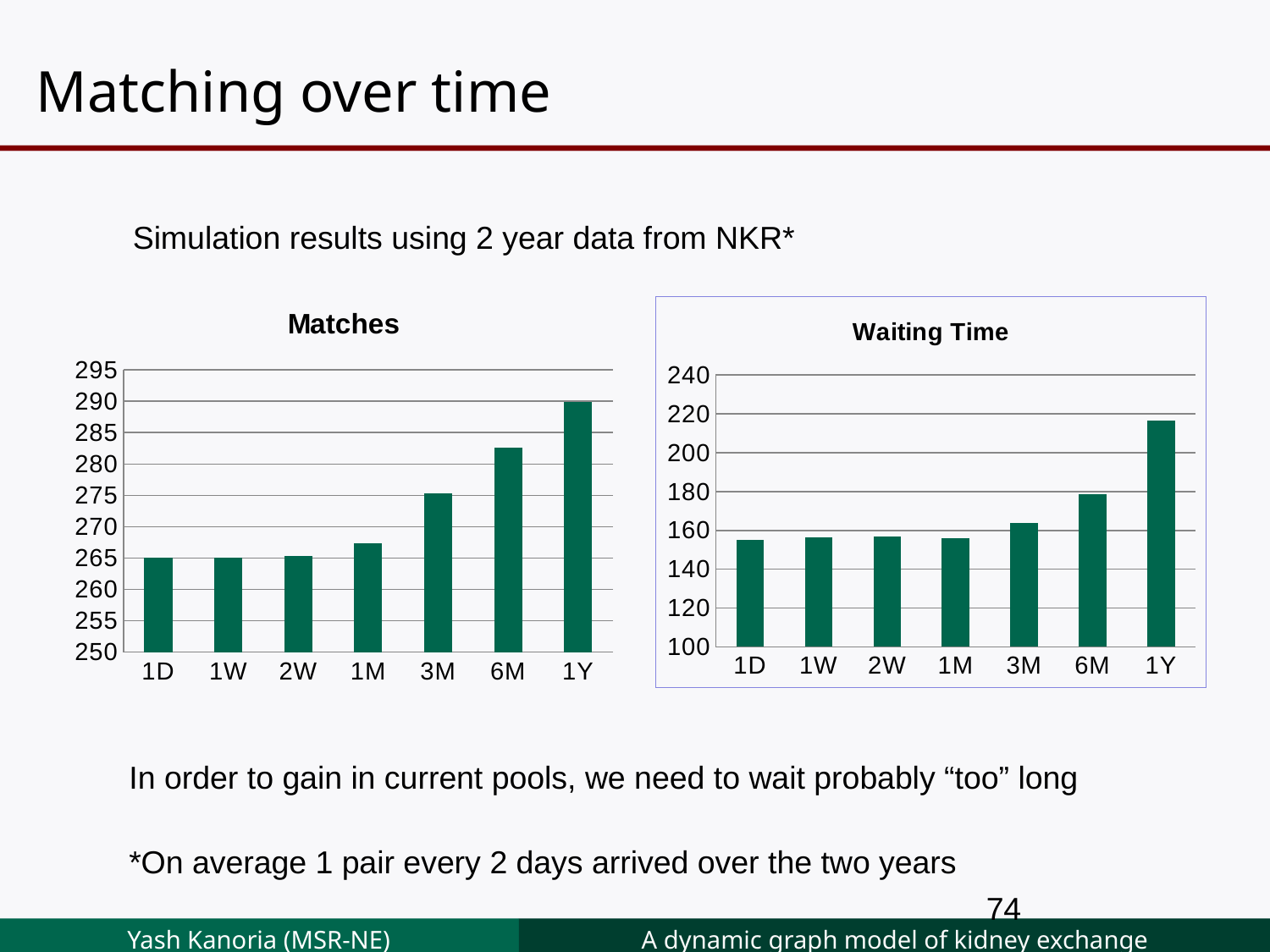
What kind of chart is the Matches chart? bar chart What is the title of the chart on the right side of the slide? Waiting Time In the Waiting Time chart, which is larger, the value for 3M or the value for 1D? 3M How many categories are shown on the x axis of the Matches chart? 7 In the Waiting Time chart, which category has the highest value? 1Y In the Matches chart, is the value for 1Y greater or less than 285? greater In the Matches chart, do the values generally rise or fall from 1D to 1Y? rise In the Waiting Time chart, is the value for 6M greater or less than 160? greater In the Matches chart, which is larger, the value for 6M or the value for 3M? 6M In the Matches chart, which category has the highest value? 1Y In the Waiting Time chart, is the value for 1Y greater or less than 200? greater